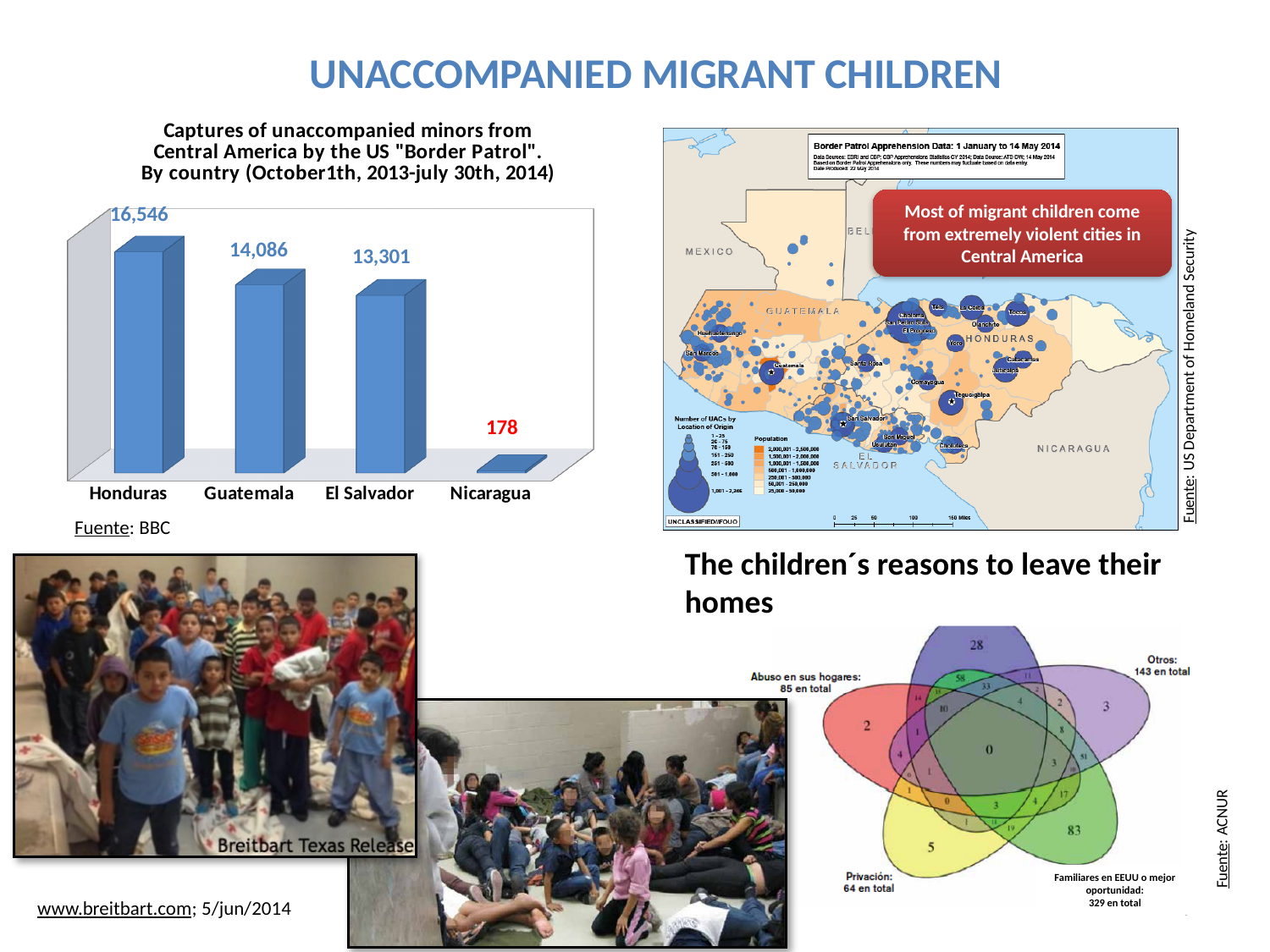
In the bar chart of captures of unaccompanied minors by country, what is the value for Guatemala? 14,086 What source is cited below the bar chart of captures of unaccompanied minors by country? BBC In the bar chart of captures of unaccompanied minors by country, what is the value for El Salvador? 13,301 In the bar chart of captures of unaccompanied minors by country, what is the difference between the values for Guatemala and El Salvador? 785 How many countries are shown in the bar chart of captures of unaccompanied minors? 4 In the bar chart of captures of unaccompanied minors by country, what is the difference between the values for Honduras and Guatemala? 2,460 In the bar chart of captures of unaccompanied minors by country, what is the value for Honduras? 16,546 In the bar chart of captures of unaccompanied minors by country, what is the value for Nicaragua? 178 In the bar chart of captures of unaccompanied minors by country, which country has the lowest value? Nicaragua What kind of chart is used to show captures of unaccompanied minors by country? bar chart In the bar chart of captures of unaccompanied minors by country, which is larger, the value for Guatemala or the value for El Salvador? Guatemala In the bar chart of captures of unaccompanied minors by country, which country has the highest value? Honduras